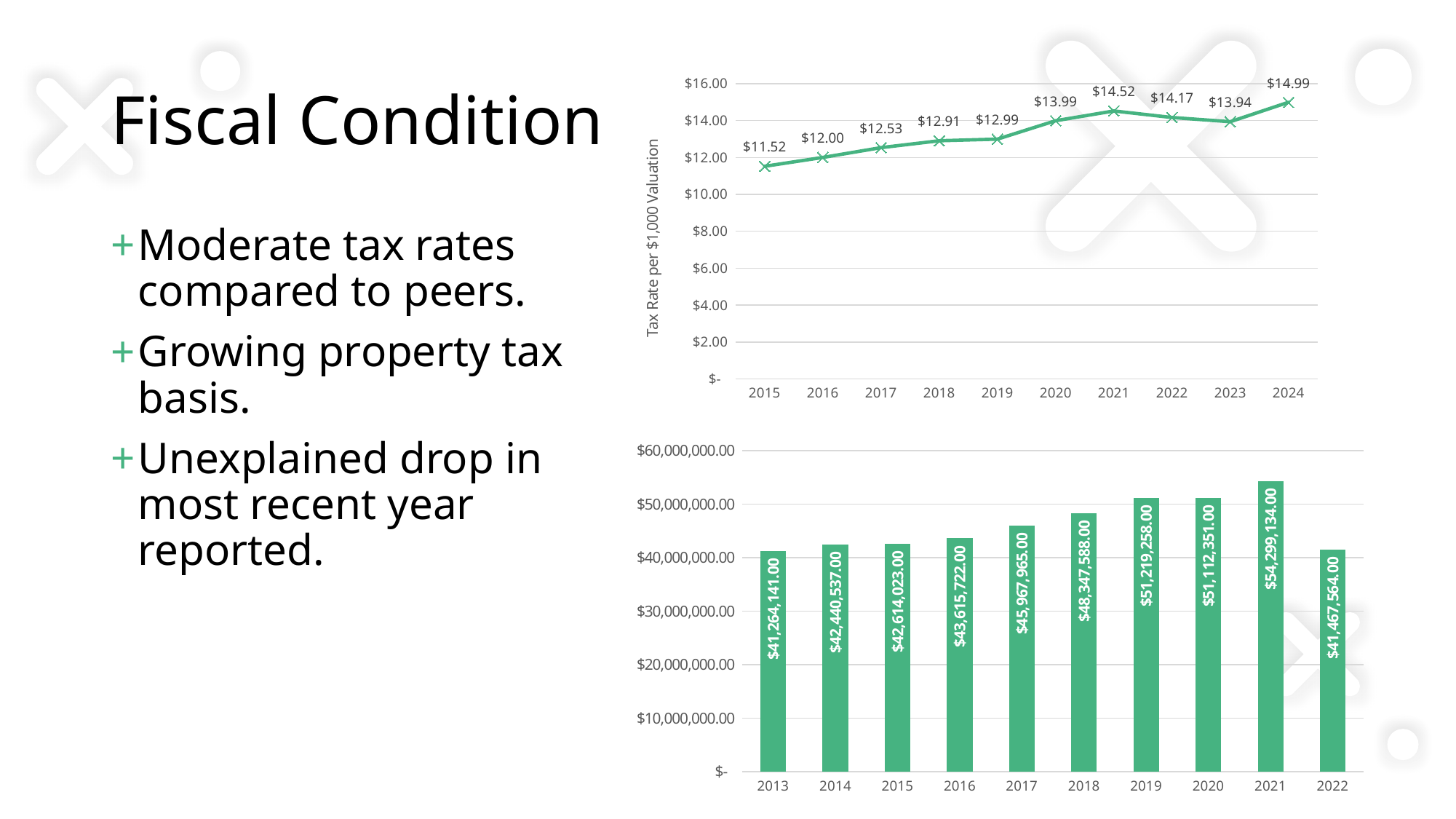
In the bottom chart, which year has the lowest value? 2013 In the top chart, how many years are plotted? 10 In the bottom chart, what is the difference between the 2021 value and the 2022 value? $12,831,570.00 In the bottom chart, what is the value for 2013? $41,264,141.00 In the top chart, what is the value for 2021? $14.52 In the top chart, which year has the lowest tax rate? 2015 In the bottom chart, what is the value for 2021? $54,299,134.00 In the top chart, what is the tax rate per $1,000 valuation for 2015? $11.52 What type of chart is the bottom chart? Bar chart In the top chart, what is the difference between the 2024 value and the 2015 value? $3.47 What type of chart is the top chart? Line chart In the top chart, which year has the highest tax rate? 2024